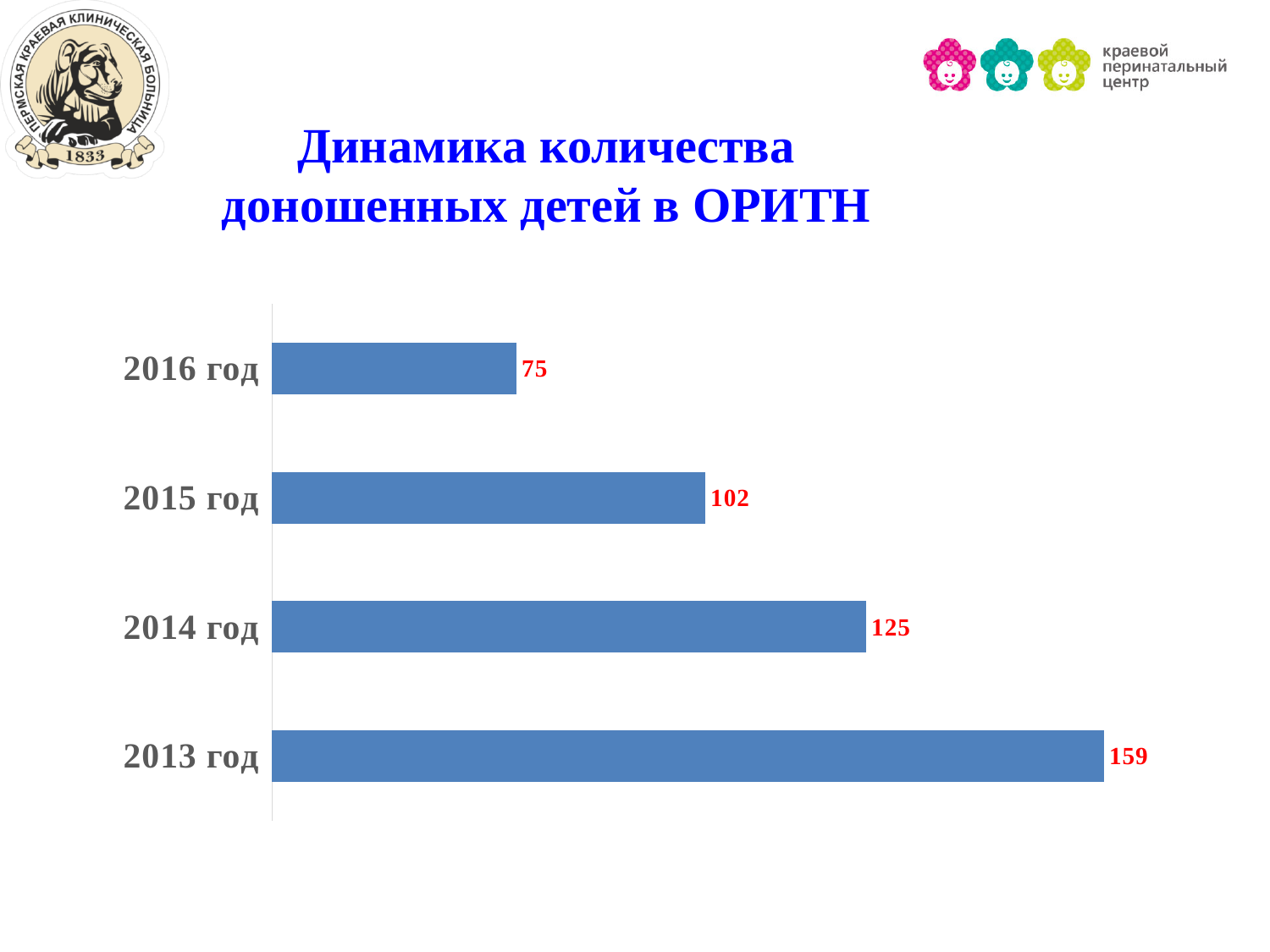
What is the difference between the values for 2014 год and 2015 год? 23 Which year has the highest value? 2013 год Which is larger, the value for 2015 год or the value for 2014 год? 2014 год What kind of chart is shown on the slide? Bar chart What is the value for 2016 год? 75 What is the value for 2015 год? 102 What is the difference between the values for 2013 год and 2016 год? 84 What is the title of the slide? Динамика количества доношенных детей в ОРИТН What is the value for 2014 год? 125 What is the value for 2013 год? 159 Which year has the lowest value? 2016 год How many years are shown in the chart? 4